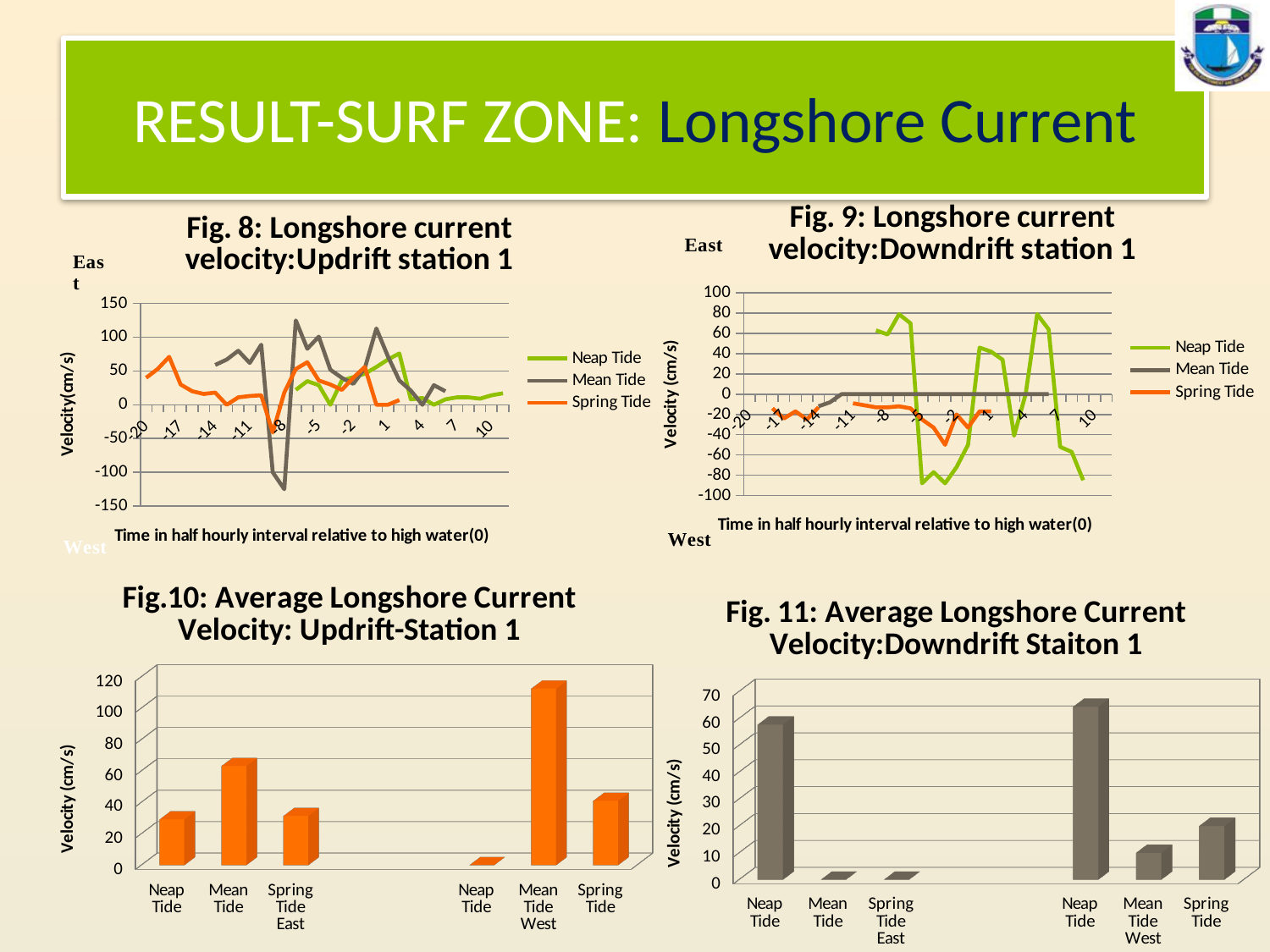
In Fig.10: Average Longshore Current Velocity: Updrift-Station 1, which bar is the lowest? Neap Tide West In Fig.10: Average Longshore Current Velocity: Updrift-Station 1, which is larger, Mean Tide East or Spring Tide East? Mean Tide East What are the legend entries in Fig. 9: Longshore current velocity: Downdrift station 1? Neap Tide, Mean Tide, Spring Tide In Fig. 11: Average Longshore Current Velocity: Downdrift Staiton 1, is the value for Neap Tide East greater or less than 50? greater In Fig. 11: Average Longshore Current Velocity: Downdrift Staiton 1, which bar is the highest? Neap Tide West What kind of chart is Fig.10: Average Longshore Current Velocity: Updrift-Station 1? Bar chart In Fig.10: Average Longshore Current Velocity: Updrift-Station 1, is the value for Mean Tide West greater or less than 100? greater What kind of chart is Fig. 8: Longshore current velocity: Updrift station 1? Line chart How many series does the legend of Fig. 8: Longshore current velocity: Updrift station 1 list? 3 In Fig.10: Average Longshore Current Velocity: Updrift-Station 1, which bar is the highest? Mean Tide West In Fig. 11: Average Longshore Current Velocity: Downdrift Staiton 1, which is larger, Spring Tide West or Mean Tide West? Spring Tide West How many bars are plotted in Fig.10: Average Longshore Current Velocity: Updrift-Station 1? 6